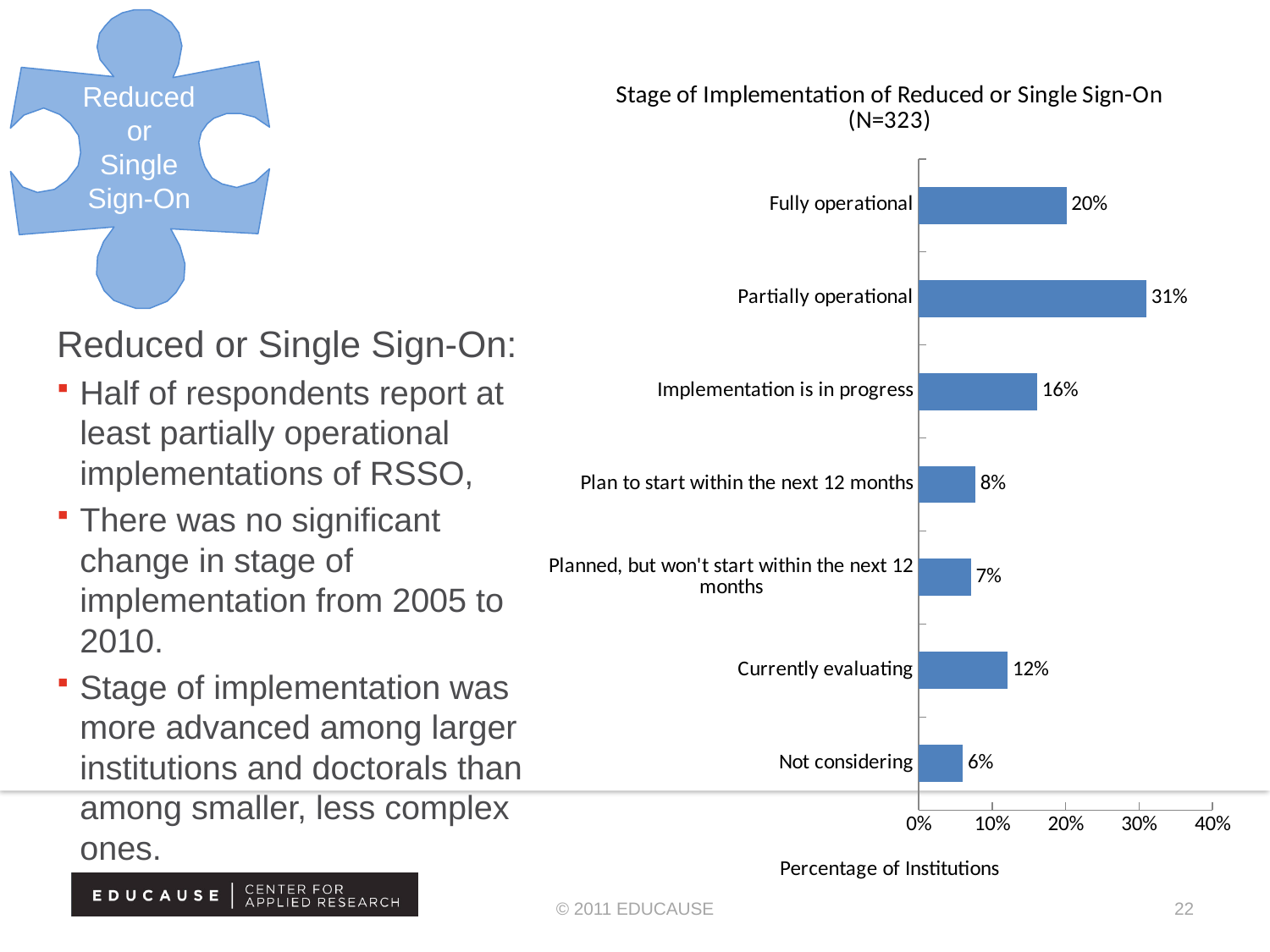
What is the value for 'Partially operational'? 31% What type of chart is used to show the stage of implementation? Bar chart What percentage of institutions are 'Currently evaluating'? 12% Which is larger: 'Implementation is in progress' or 'Currently evaluating'? Implementation is in progress Which stage of implementation has the highest percentage of institutions? Partially operational Which stage of implementation has the lowest percentage of institutions? Not considering What percentage of institutions report Reduced or Single Sign-On as fully operational? 20% How many stages of implementation are shown in the chart? 7 What is the label of the horizontal axis? Percentage of Institutions What is the difference in percentage points between 'Partially operational' and 'Fully operational'? 11 What is the sample size (N) given in the chart title? 323 What is the value for 'Planned, but won't start within the next 12 months'? 7%